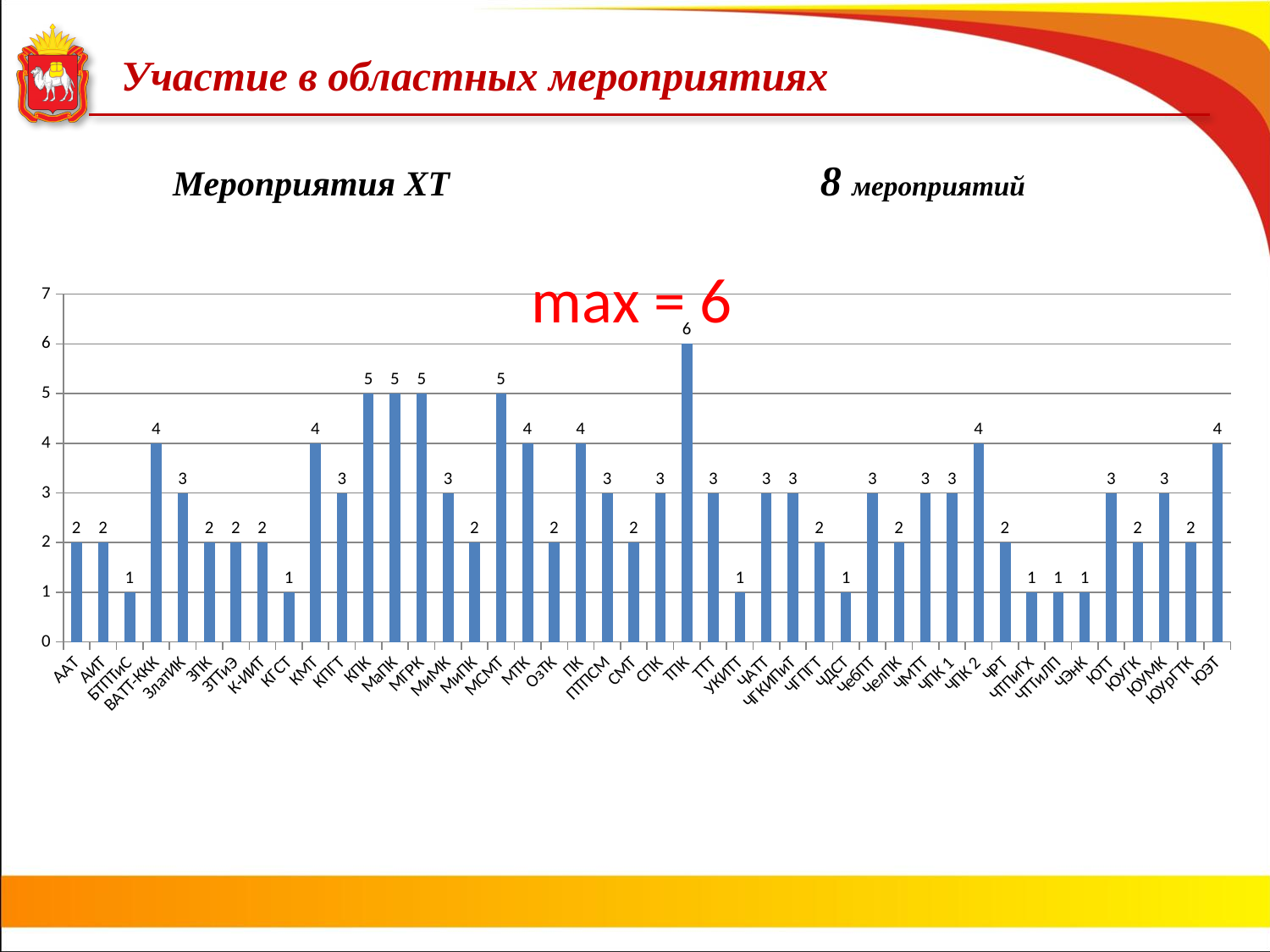
What is the value for ТПК? 6 Which is larger, the value for ЮЭТ or the value for ЮУрГТК? ЮЭТ What is the difference between the values for ТПК and МСМТ? 1 What maximum value is written in red text above the chart? max = 6 What is the lowest value shown in the chart? 1 Which category has the highest value in the chart? ТПК What is the value for ЧПК 2? 4 What is the value for КПК? 5 Which is larger, the value for МГРК or the value for МиМК? МГРК What is the value for ЧЭнК? 1 What type of chart is shown on the slide? bar chart